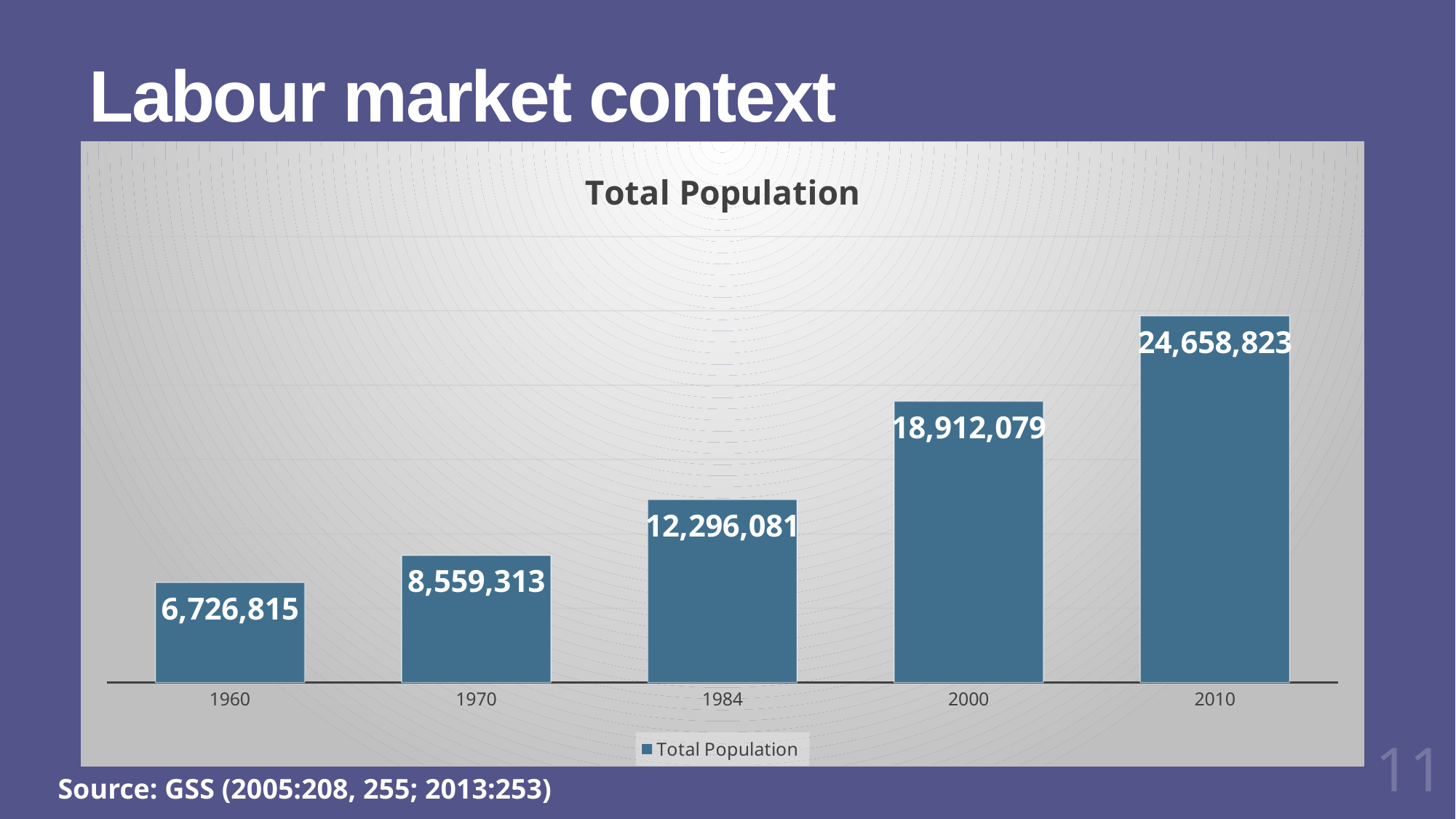
What is the total population shown for 1984? 12,296,081 What is the total population shown for 1960? 6,726,815 What is the difference in total population between 2010 and 2000? 5,746,744 Does the total population rise or fall from 1960 to 2010? Rise What is the difference in total population between 1970 and 1960? 1,832,498 What is the total population shown for 2010? 24,658,823 What kind of chart is shown on the slide? Bar chart What is the total population shown for 2000? 18,912,079 Which year has a larger total population, 1984 or 2000? 2000 How many years are shown on the x axis of the chart? 5 Which year has the highest total population? 2010 Which year has the lowest total population? 1960